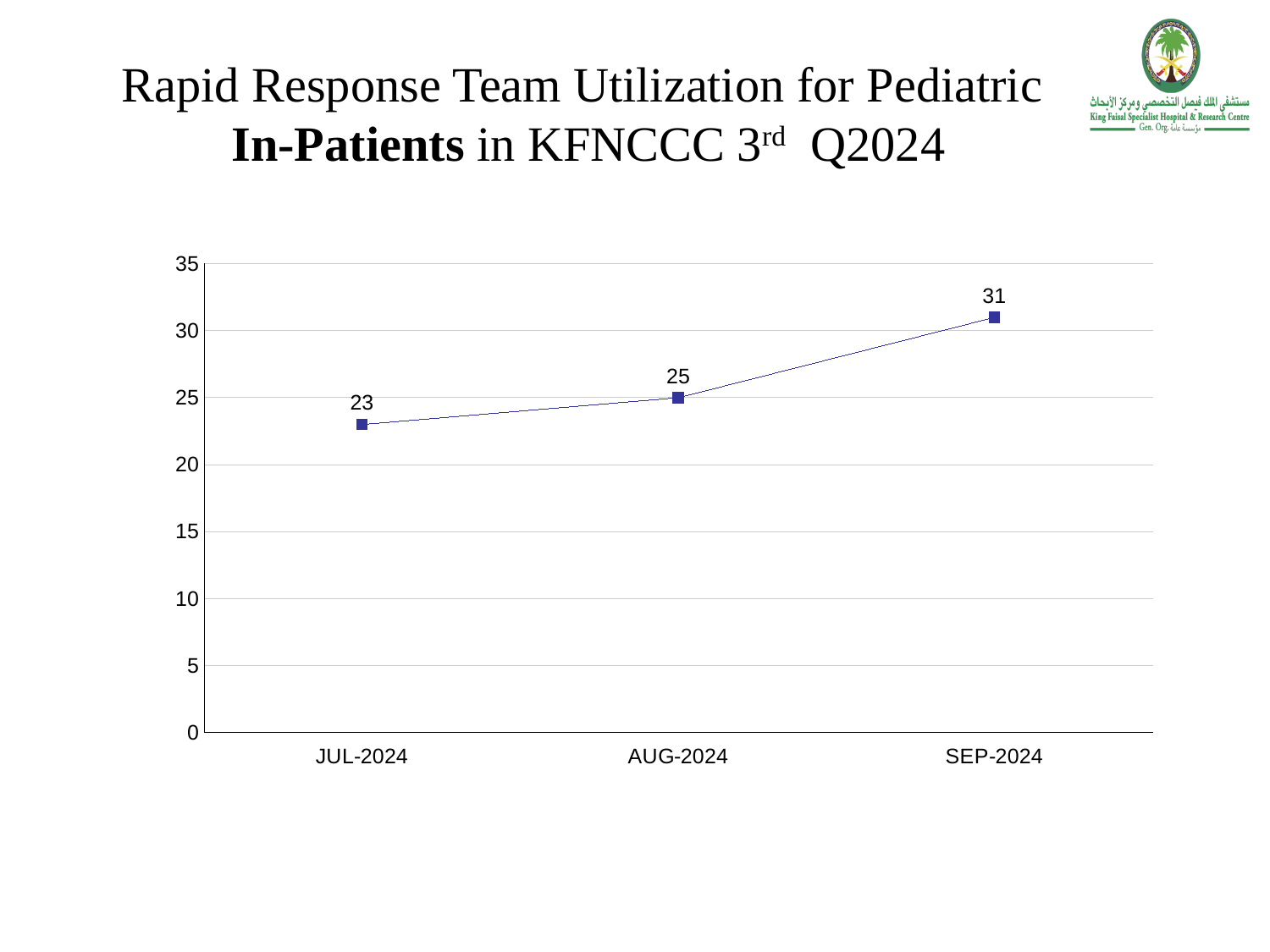
What is the value for AUG-2024? 25 What is the difference between the values for SEP-2024 and JUL-2024? 8 Which month has the highest value? SEP-2024 Is the value for SEP-2024 greater or less than 30? greater Which month has the lowest value? JUL-2024 What is the value for JUL-2024? 23 How many months are plotted on the chart? 3 Do the values rise or fall from JUL-2024 to SEP-2024? rise What kind of chart is shown on the slide? line chart What is the difference between the values for AUG-2024 and JUL-2024? 2 What is the value for SEP-2024? 31 Which is larger, the value for AUG-2024 or the value for SEP-2024? SEP-2024